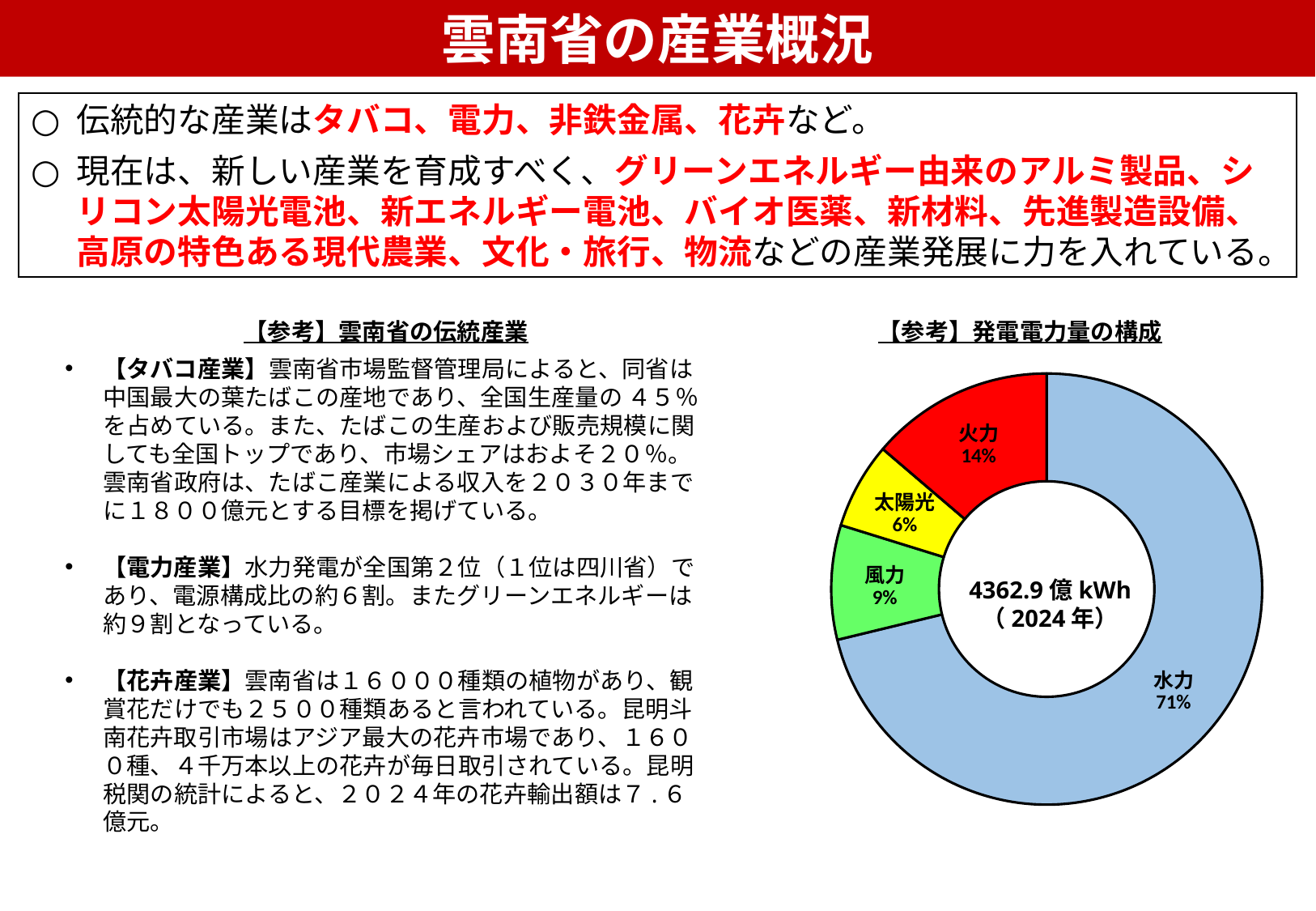
What is the difference in percentage points between the 水力 share and the 火力 share? 57 How many energy sources are shown in the chart? 4 What share of the power generation mix does 太陽光 (solar) account for? 6% What kind of chart is used to show the power generation mix? Pie (doughnut) chart What share of the power generation mix does 風力 (wind) account for? 9% What share of the power generation mix does 火力 (thermal) account for? 14% Which has a larger share, 風力 or 太陽光? 風力 What total generation amount is printed in the centre of the chart? 4362.9 億 kWh Which energy source has the smallest share of the power generation mix? 太陽光 Which energy source has the largest share of the power generation mix? 水力 What year does the power generation mix chart refer to? 2024 年 What share of the power generation mix does 水力 (hydro) account for? 71%